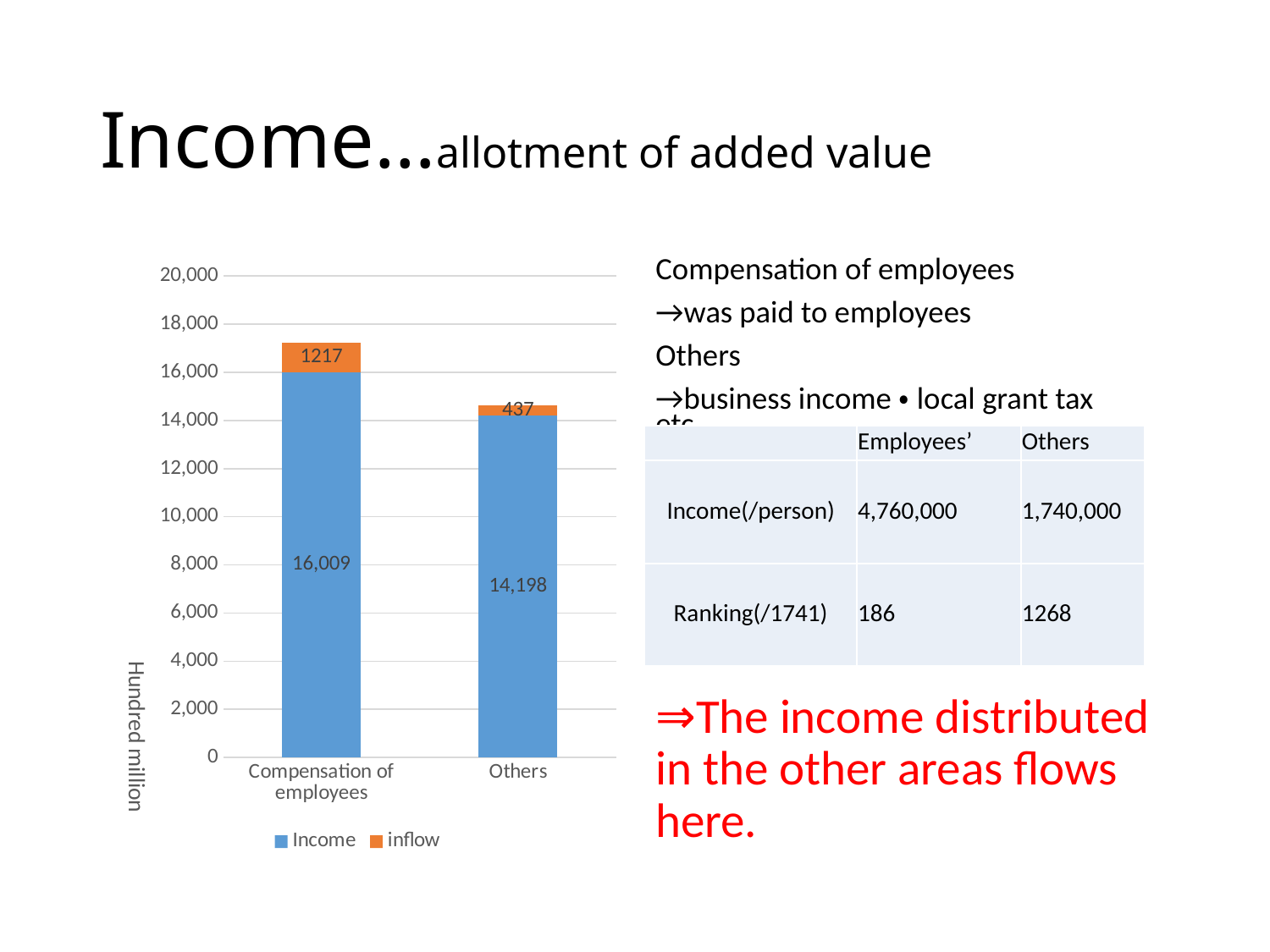
What is the total of the stacked bar for Others? 14,635 Which category has the higher Income value? Compensation of employees Which category has the lower inflow value? Others What is the total of the stacked bar for Compensation of employees? 17,226 How many series does the legend list? 2 What is the difference between the Income values for Compensation of employees and Others? 1,811 What is the difference between the inflow values for Compensation of employees and Others? 780 What kind of chart is shown on the slide? Stacked bar chart What is the Income value for Others? 14,198 What is the Income value for Compensation of employees? 16,009 What is the inflow value for Others? 437 What is the inflow value for Compensation of employees? 1217